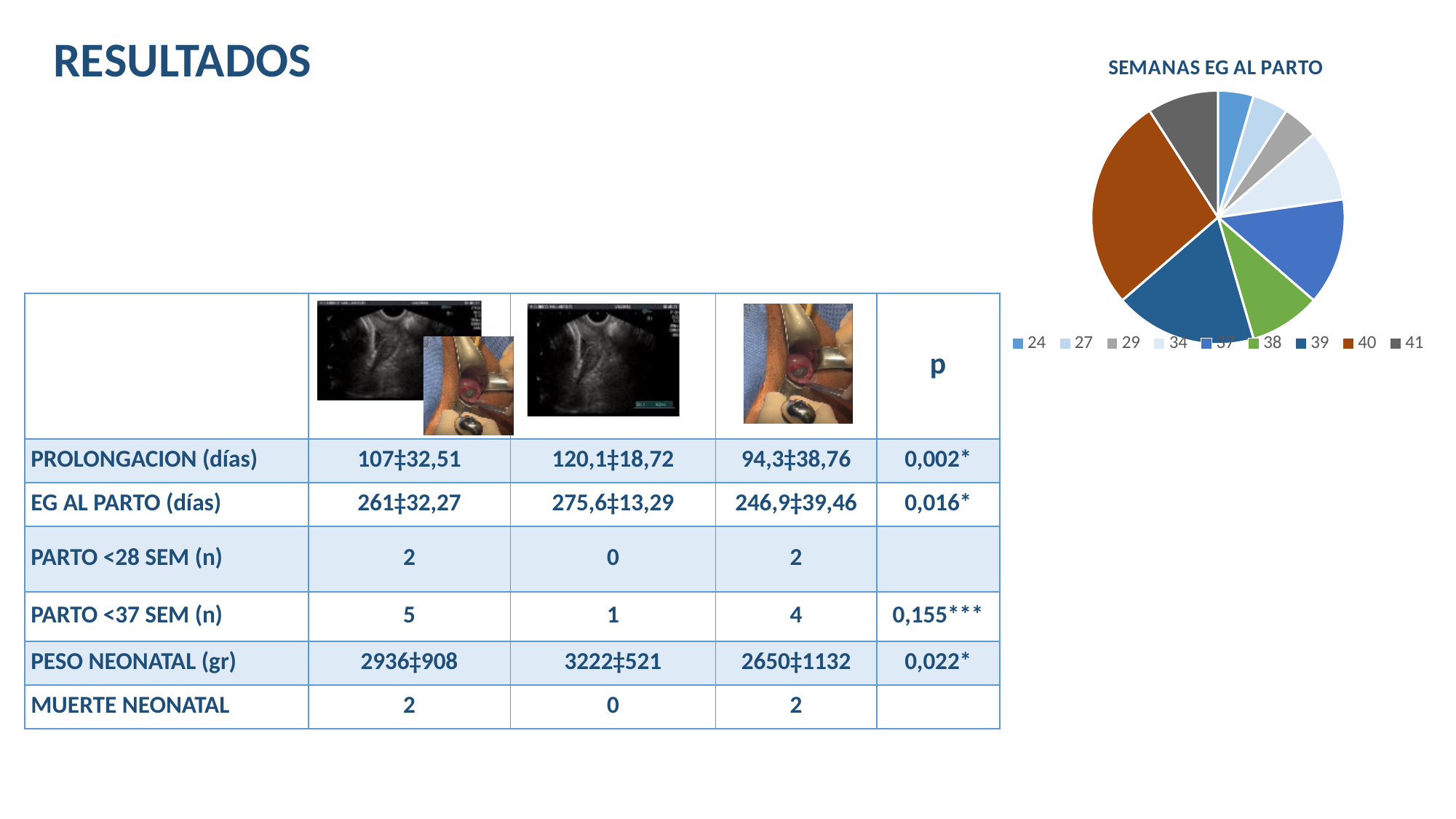
In the pie chart, which slice is larger: 41 or 24? 41 In the pie chart, which slice is larger: 40 or 39? 40 In the pie chart, which slice is larger: 37 or 38? 37 What colour is the slice for category 40 in the pie chart? orange-brown How many categories does the pie chart's legend list? 9 What kind of chart is shown on the slide? pie chart What is the title of the pie chart? SEMANAS EG AL PARTO Which category has the largest slice in the pie chart? 40